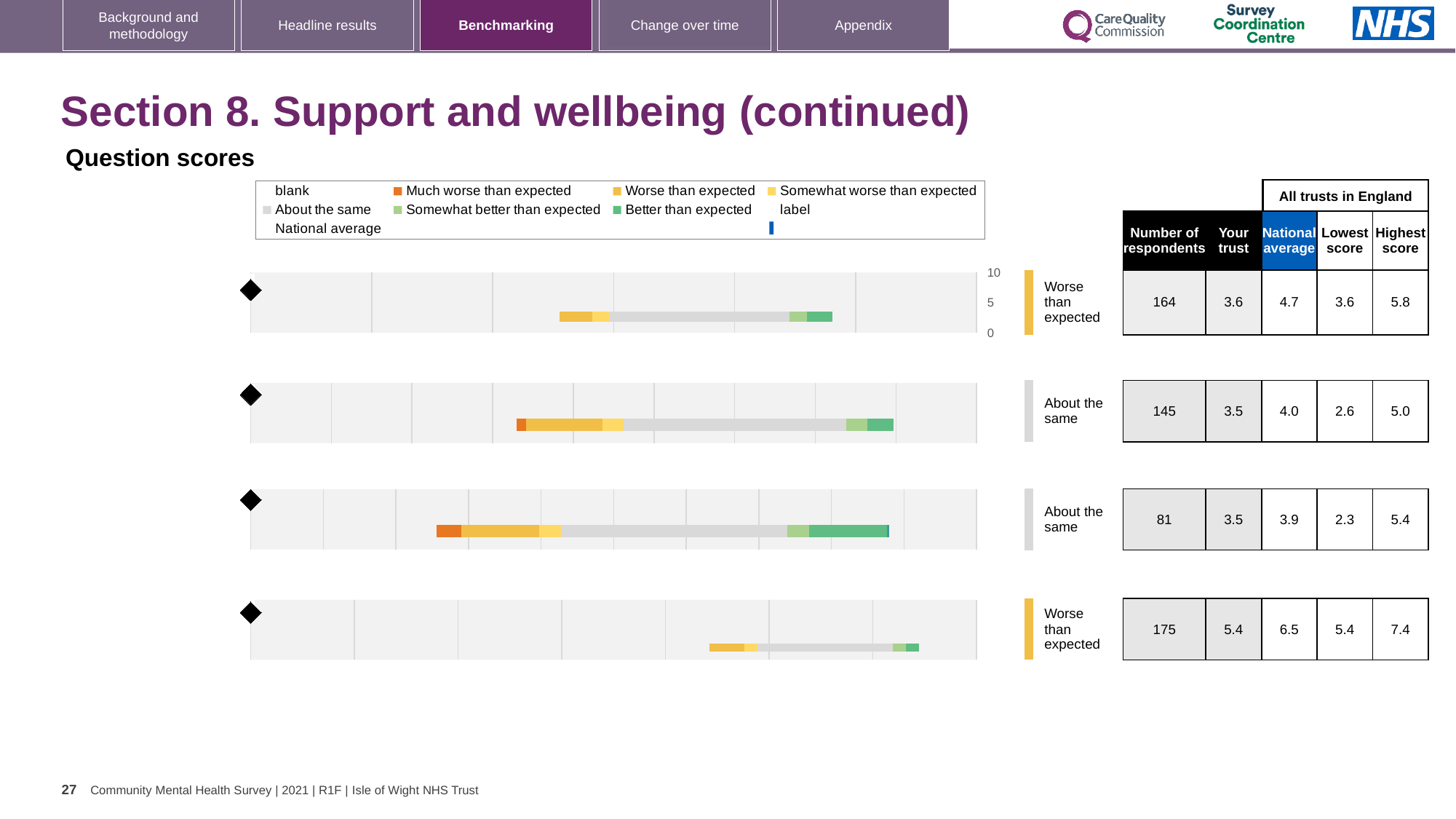
For the top chart, what is the national average score? 4.7 What kind of chart is used to show the question scores on this slide? bar chart What benchmark label is shown next to the top chart? Worse than expected For the top chart, what is the difference between the national average and the 'Your trust' score? 1.1 For the bottom chart, how many respondents are there? 175 For the top chart, is the 'Your trust' score greater or less than 5? less For the top chart, what is the 'Your trust' score? 3.6 Which chart has the highest 'Your trust' score? the bottom (fourth) chart Which chart has the lowest number of respondents? the third chart Which has the higher national average: the second chart or the third chart? the second chart For the bottom chart, what is the difference between the highest score and the lowest score? 2.0 How many question score charts are shown on the slide? 4